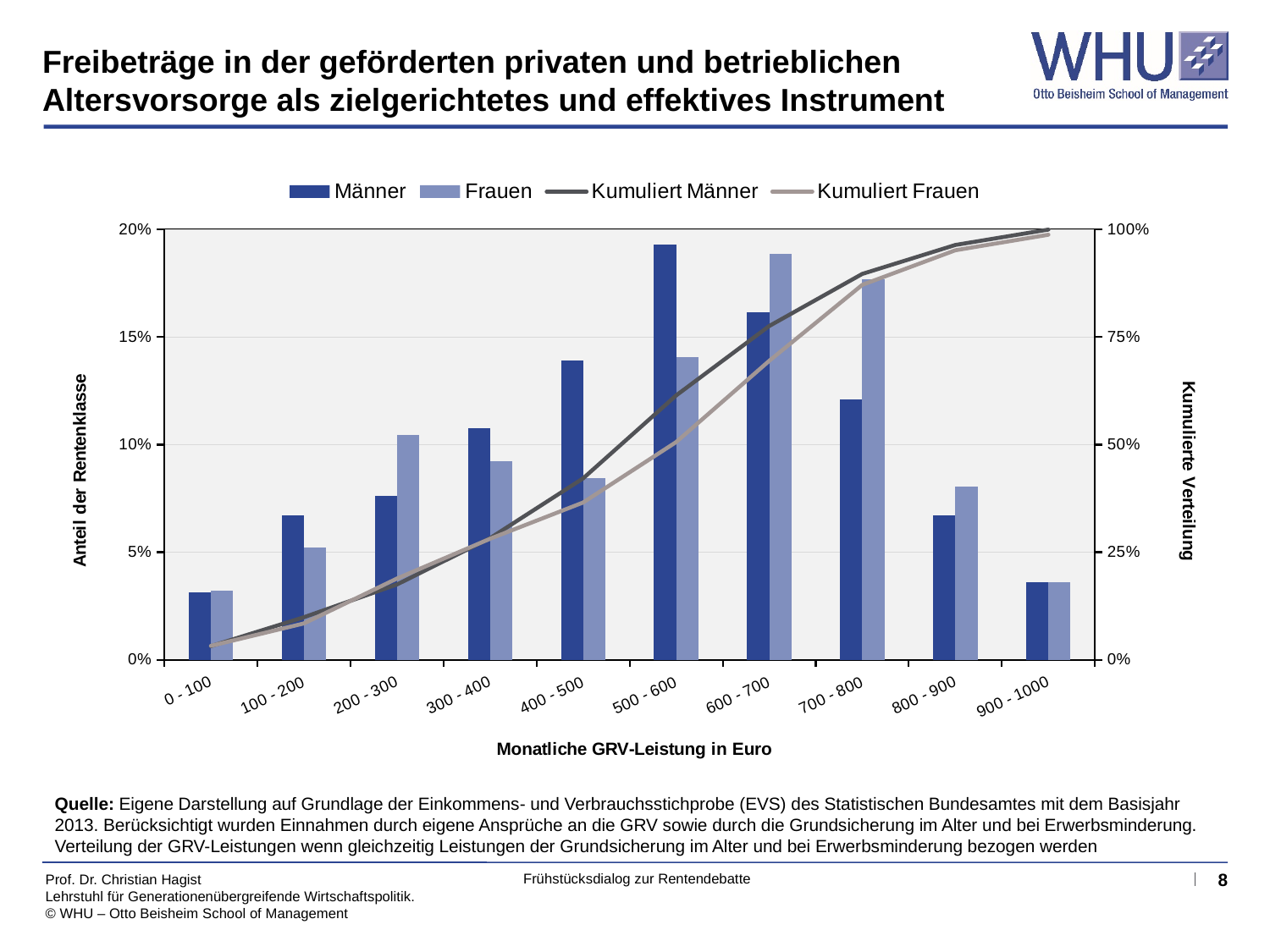
In the 600 - 700 category, which bar is larger, Männer or Frauen? Frauen Is the Männer value for 700 - 800 greater or less than 10%? greater Is the Männer value for 500 - 600 greater or less than 15%? greater Which category has the highest Frauen bar? 600 - 700 Is the Frauen value for 400 - 500 greater or less than 10%? less How many series does the legend list? 4 What is the title of the x axis? Monatliche GRV-Leistung in Euro In the 500 - 600 category, which bar is larger, Männer or Frauen? Männer Do the Kumuliert Männer and Kumuliert Frauen lines rise or fall along the x axis? rise How many income categories are shown on the x axis? 10 Which category has the highest Männer bar? 500 - 600 What kind of chart is shown on the slide? A bar chart combined with line series